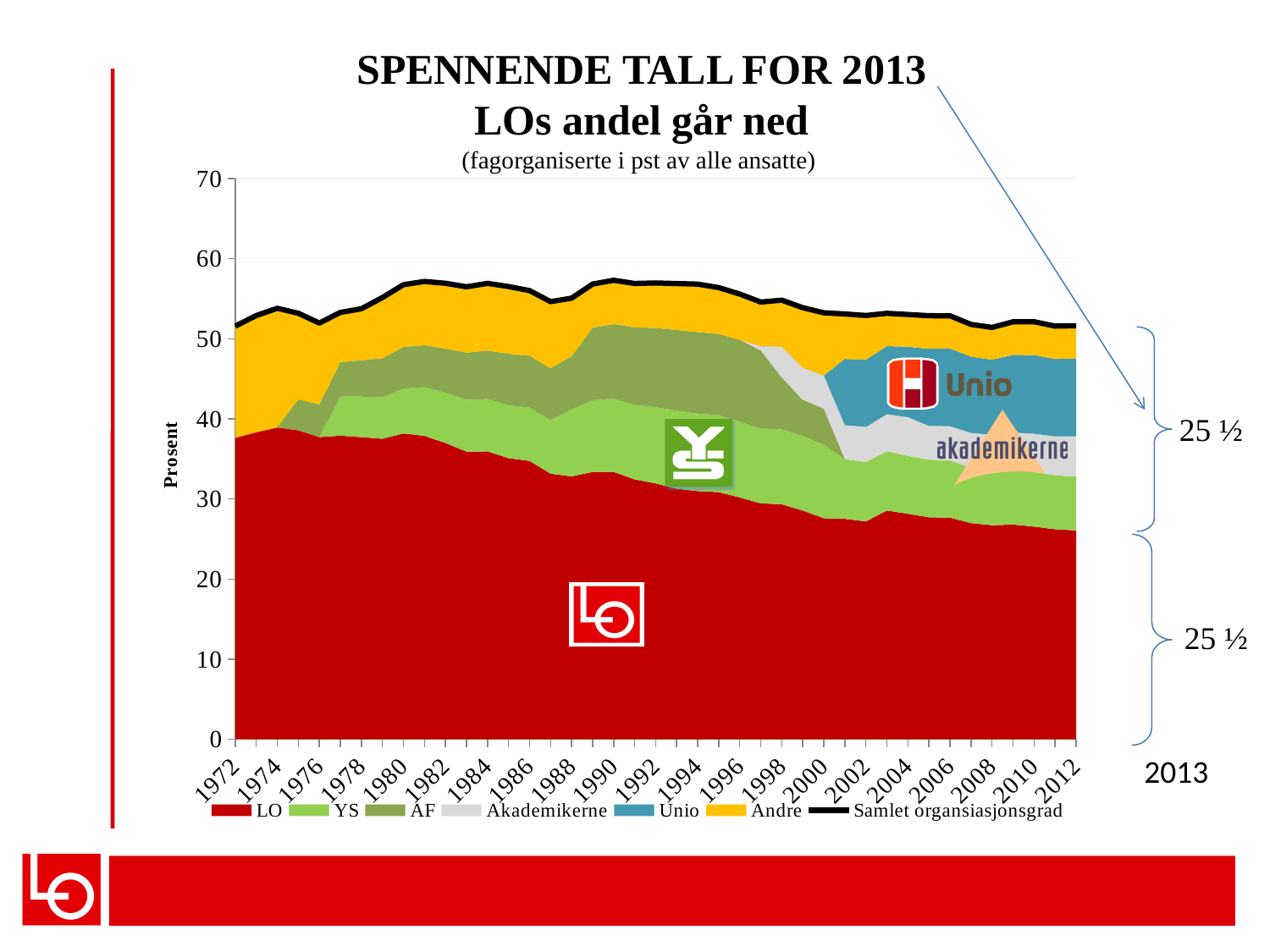
What is the label on the vertical axis? Prosent What is the title of the chart? LOs andel går ned How many year labels are shown on the x axis? 21 How many series does the legend list? 7 Is the value for LO in 2012 greater or less than 30? less What is the highest value shown on the vertical axis? 70 Which series is larger in 2012, LO or YS? LO Is the value of the Samlet organsiasjonsgrad line in 1980 greater or less than 55? greater Does the LO share rise or fall from 1972 to 2012? Fall Is the value for LO in 1974 greater or less than 35? greater What kind of chart is shown on the slide? Stacked area chart with a line